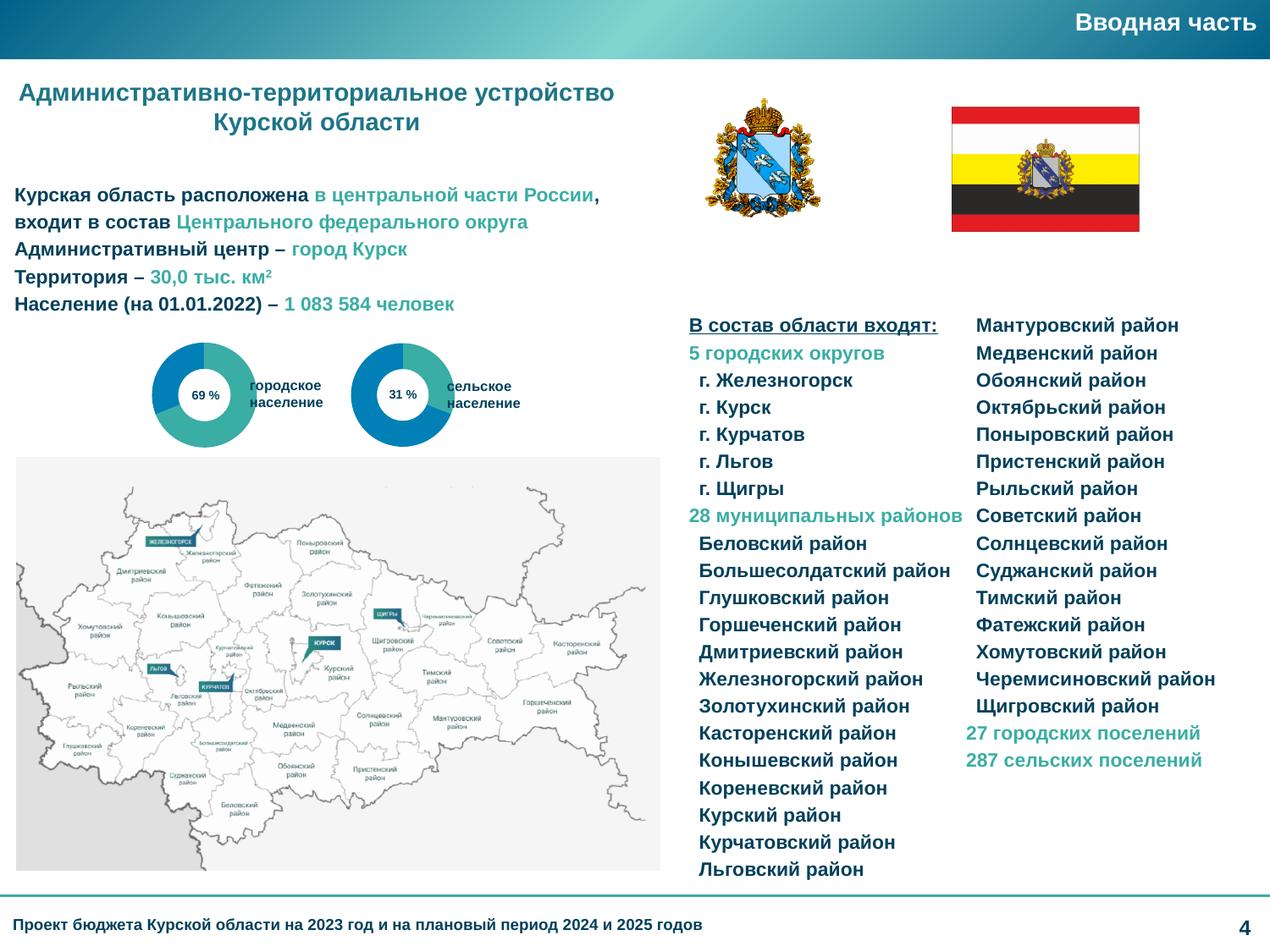
How many donut charts are shown on the slide? 2 By how many percentage points does the urban population share (69 %) exceed the rural population share (31 %)? 38 % Which is larger according to the donut charts: городское население or сельское население? городское население What do the urban (69 %) and rural (31 %) population shares add up to? 100 % What is the label next to the left donut chart? городское население Which population group has the smaller share in the donut charts? сельское население What kind of charts are used to show the urban and rural population shares on the slide? pie (donut) charts What is the label next to the right donut chart? сельское население In the right donut chart, what percentage is shown for сельское население? 31 % In the left donut chart, what percentage is shown for городское население? 69 %